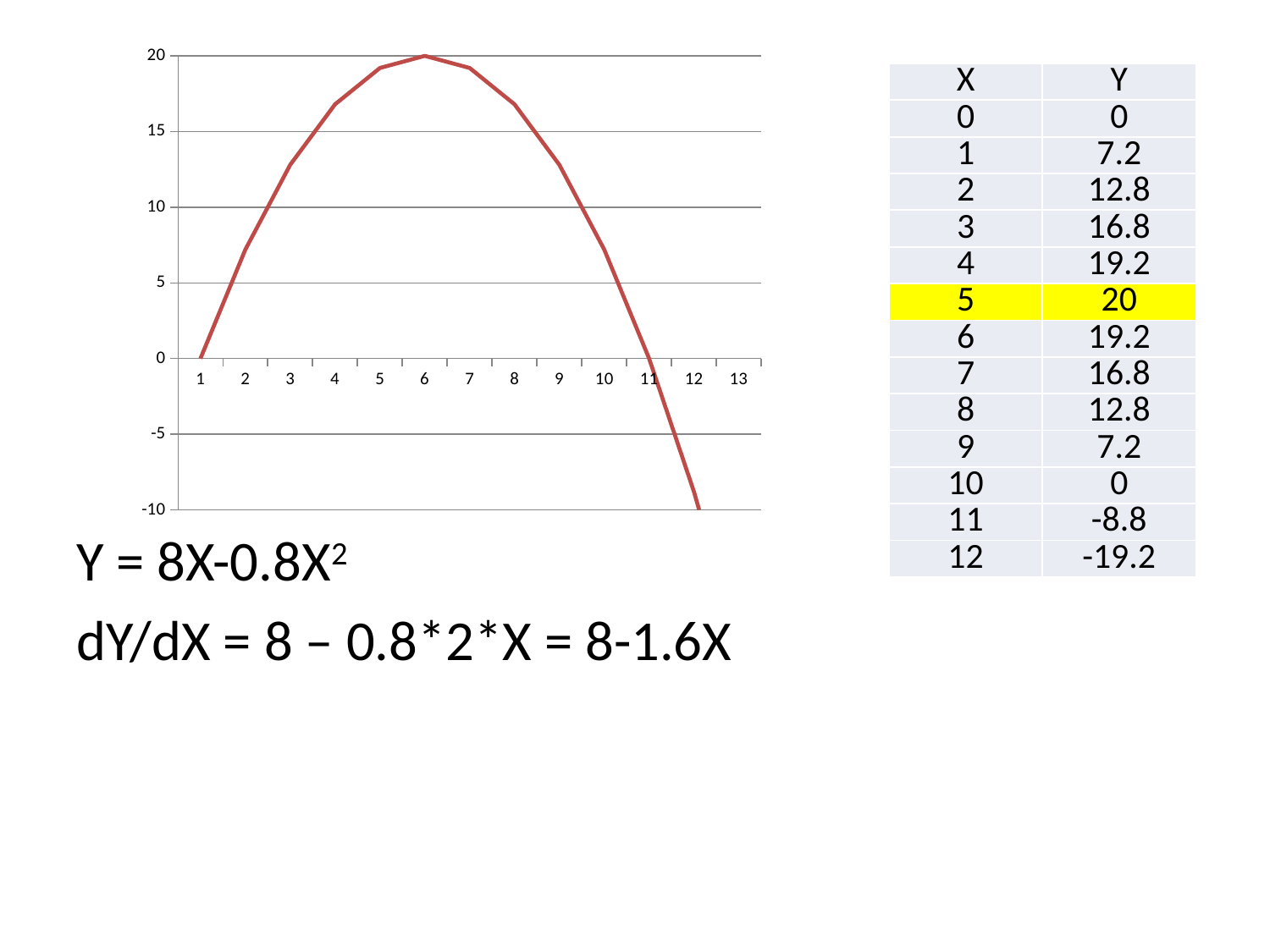
What kind of chart is shown on the slide? line chart At which x-axis category does the line reach its highest value? 6 What is the value of the line at x-axis category 1? 0 What is the value of the line at x-axis category 6? 20 Which has the larger value, x-axis category 4 or x-axis category 10? 4 Is the value at x-axis category 12 greater or less than -5? less Is the value at x-axis category 2 greater or less than 5? greater Does the line rise or fall from x-axis category 1 to category 6? rise What colour is the plotted line? red Is the value at x-axis category 3 greater or less than 10? greater Does the line rise or fall from x-axis category 6 to category 12? fall